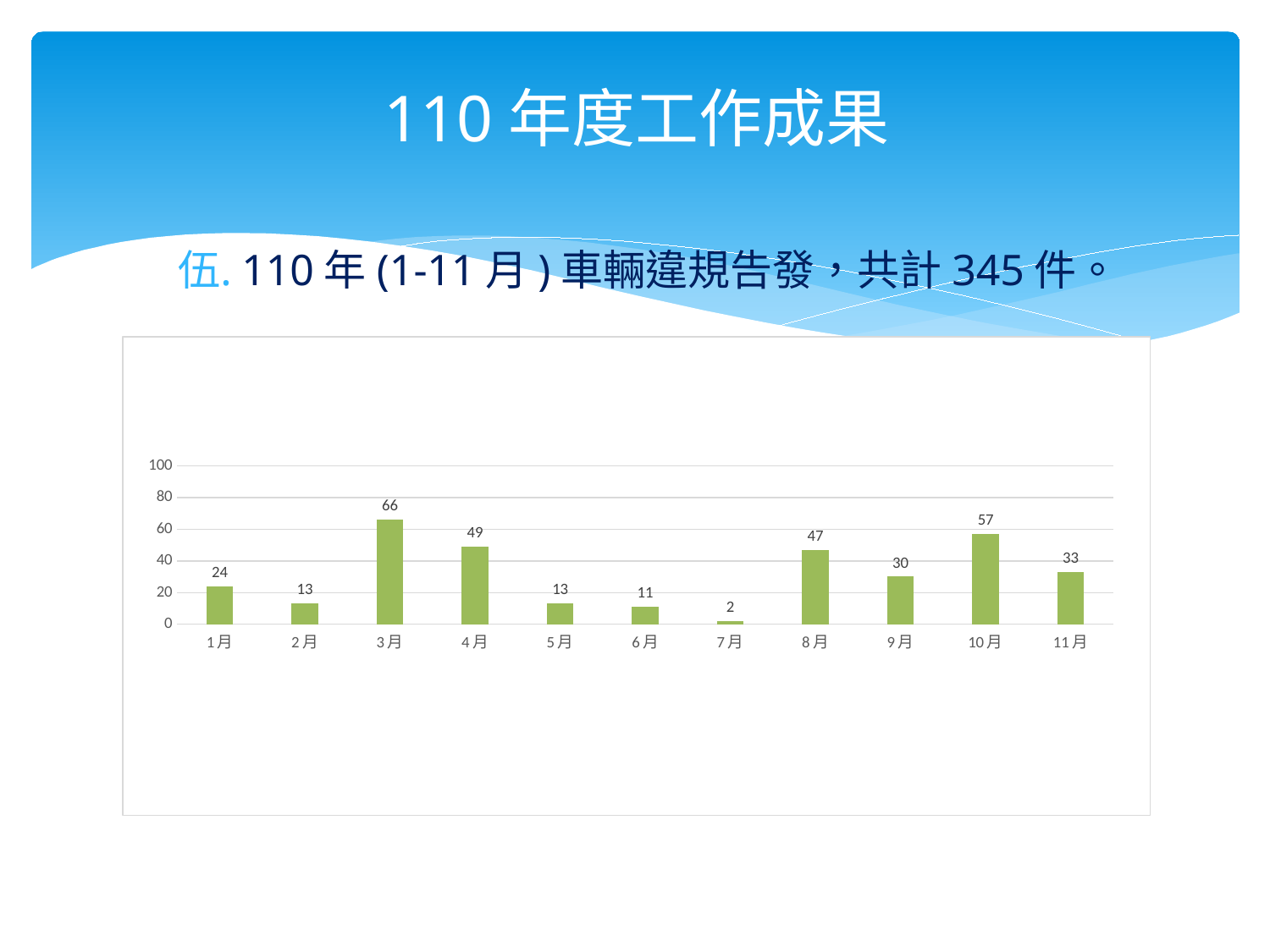
What is the value for 9月? 30 What is the difference between the values for 10月 and 11月? 24 Which month has the lowest value? 7月 Which month has the highest value? 3月 What is the value for 7月? 2 Which is larger, the value for 8月 or the value for 9月? 8月 What kind of chart is shown on the slide? bar chart Do the values rise or fall from 8月 to 9月? fall What is the value for 3月? 66 What is the value for 10月? 57 How many months are shown on the x axis? 11 What is the difference between the values for 3月 and 4月? 17